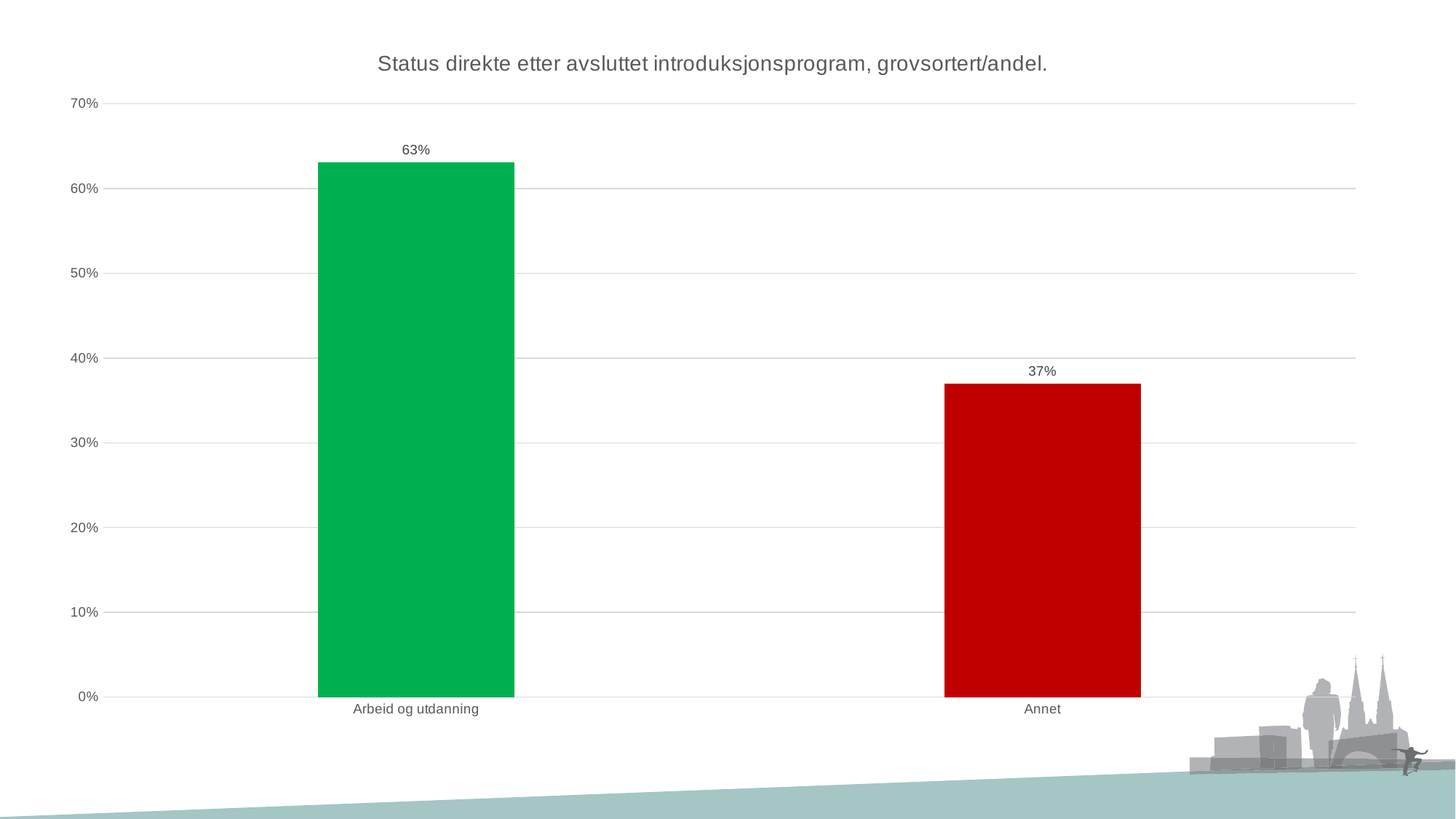
What is the value for Annet? 37% What kind of chart is shown on the slide? Bar chart Which category has the lowest value? Annet How many categories are shown on the chart? 2 Is the value for Annet greater or less than 40%? less What is the title of the chart? Status direkte etter avsluttet introduksjonsprogram, grovsortert/andel. What is the difference between the values for Arbeid og utdanning and Annet? 26% Which is larger, the value for Arbeid og utdanning or the value for Annet? Arbeid og utdanning What colour is the bar for Annet? Red Which category has the highest value? Arbeid og utdanning Is the value for Arbeid og utdanning greater or less than 60%? greater What is the value for Arbeid og utdanning? 63%